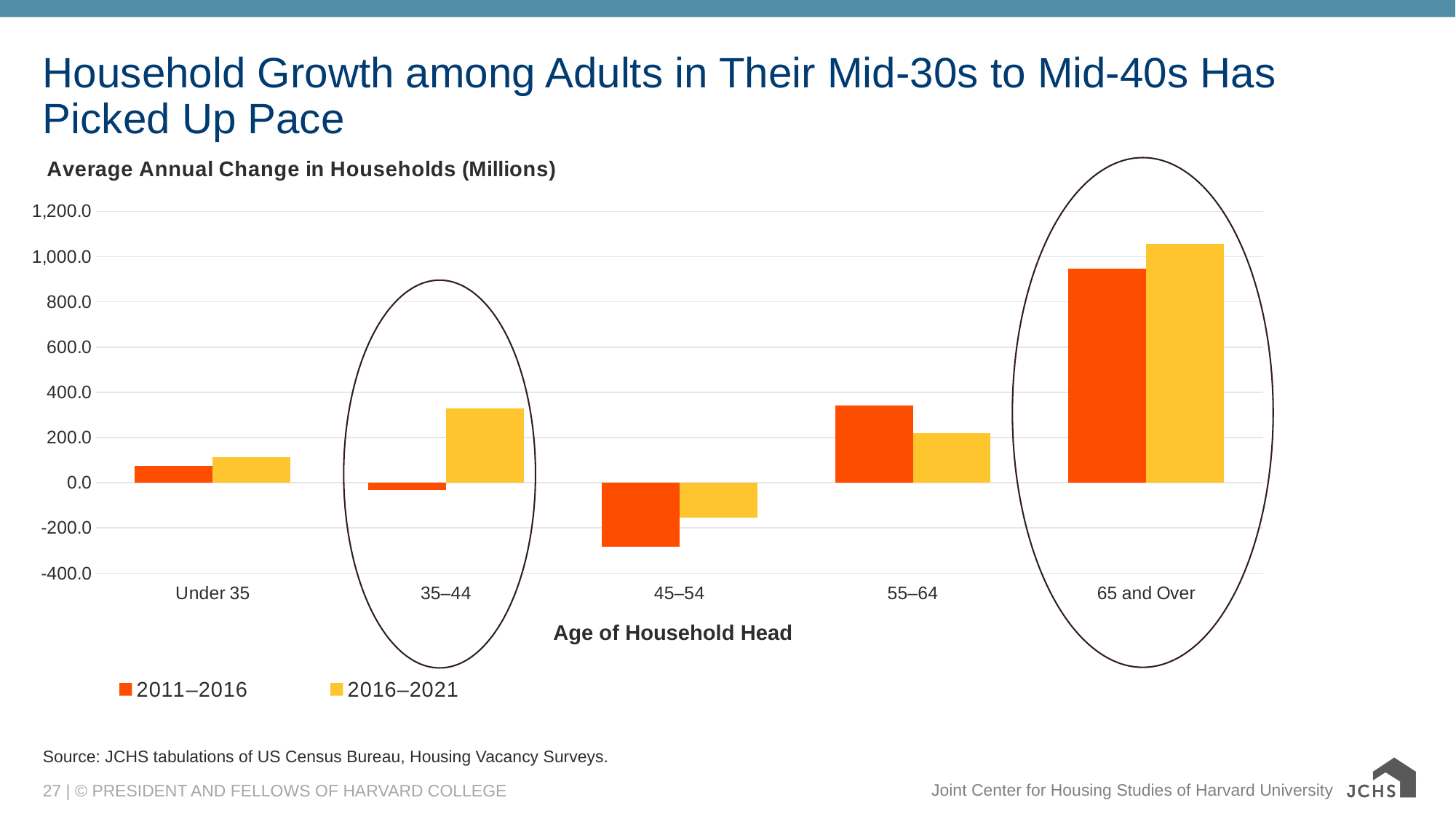
For the 35–44 age group, which series has the larger value, 2011–2016 or 2016–2021? 2016–2021 What kind of chart is shown on the slide? Bar chart Which age group has the highest value for 2016–2021? 65 and Over What is the title of the x axis? Age of Household Head Is the 2011–2016 value for 45–54 greater or less than -200.0? less How many age groups are shown on the x axis? 5 Is the 2016–2021 value for 65 and Over greater or less than 1,000.0? greater Is the 2011–2016 value for 65 and Over greater or less than 1,000.0? less Which age group has the lowest value for 2011–2016? 45–54 How many series does the legend list? 2 Which age group has the highest value for 2011–2016? 65 and Over For the 55–64 age group, which series has the larger value, 2011–2016 or 2016–2021? 2011–2016